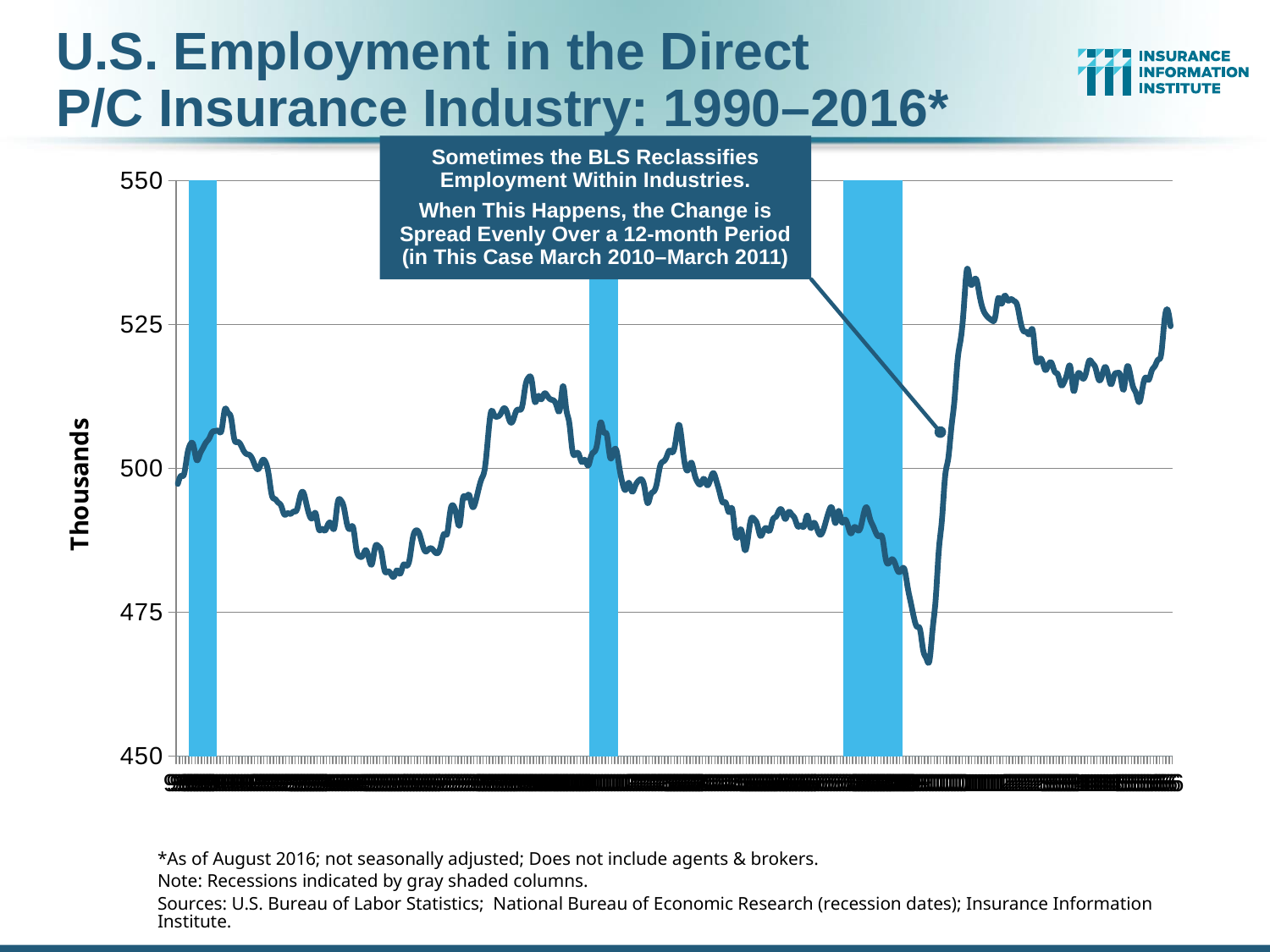
Comparing the start of the line to its end, does employment rise or fall overall? rise Is the value at the end of the line (right end) greater or less than 550? less Is the value at the start of the line (left end) greater or less than 500? less What kind of chart is shown on the slide? line chart What is the label on the vertical axis of the chart? Thousands Is the value at the end of the line (right end) greater or less than 500? greater What is the highest value shown on the vertical axis of the chart? 550 Is the value at the end of the line higher or lower than the value at the start of the line? higher How many shaded recession columns are shown on the chart? 3 What is the title of the chart on the slide? U.S. Employment in the Direct P/C Insurance Industry: 1990–2016*